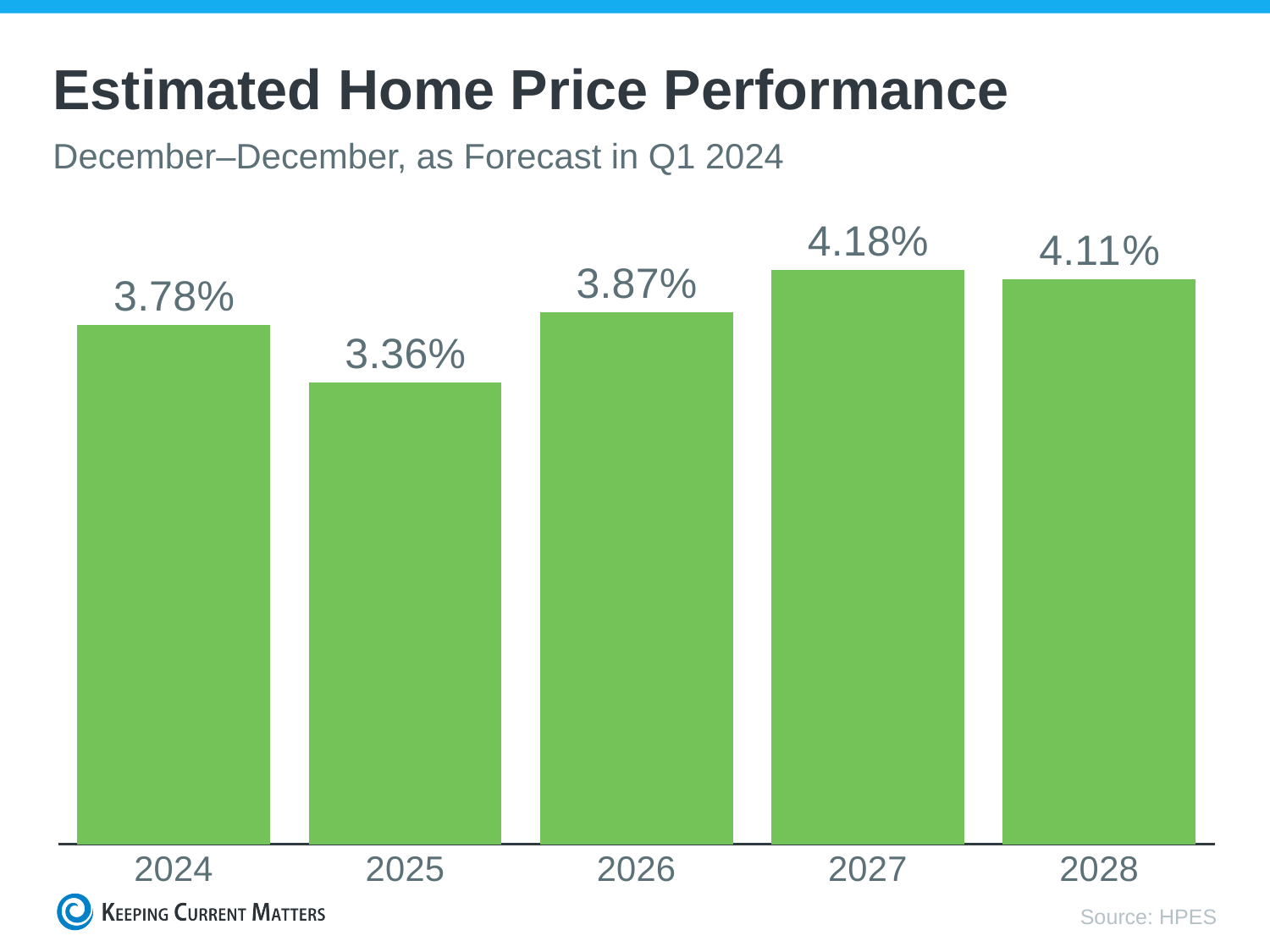
What is the estimated home price performance for 2028? 4.11% What is the subtitle of the chart? December–December, as Forecast in Q1 2024 What is the estimated home price performance for 2025? 3.36% What is the estimated home price performance for 2027? 4.18% Which is larger, the value for 2024 or the value for 2025? 2024 How many years are shown on the chart? 5 What is the estimated home price performance for 2024? 3.78% What is the difference between the 2026 and 2024 values? 0.09% Which year has the lowest estimated home price performance? 2025 What is the difference between the 2027 and 2025 values? 0.82% Which year has the highest estimated home price performance? 2027 What kind of chart is shown on the slide? Bar chart